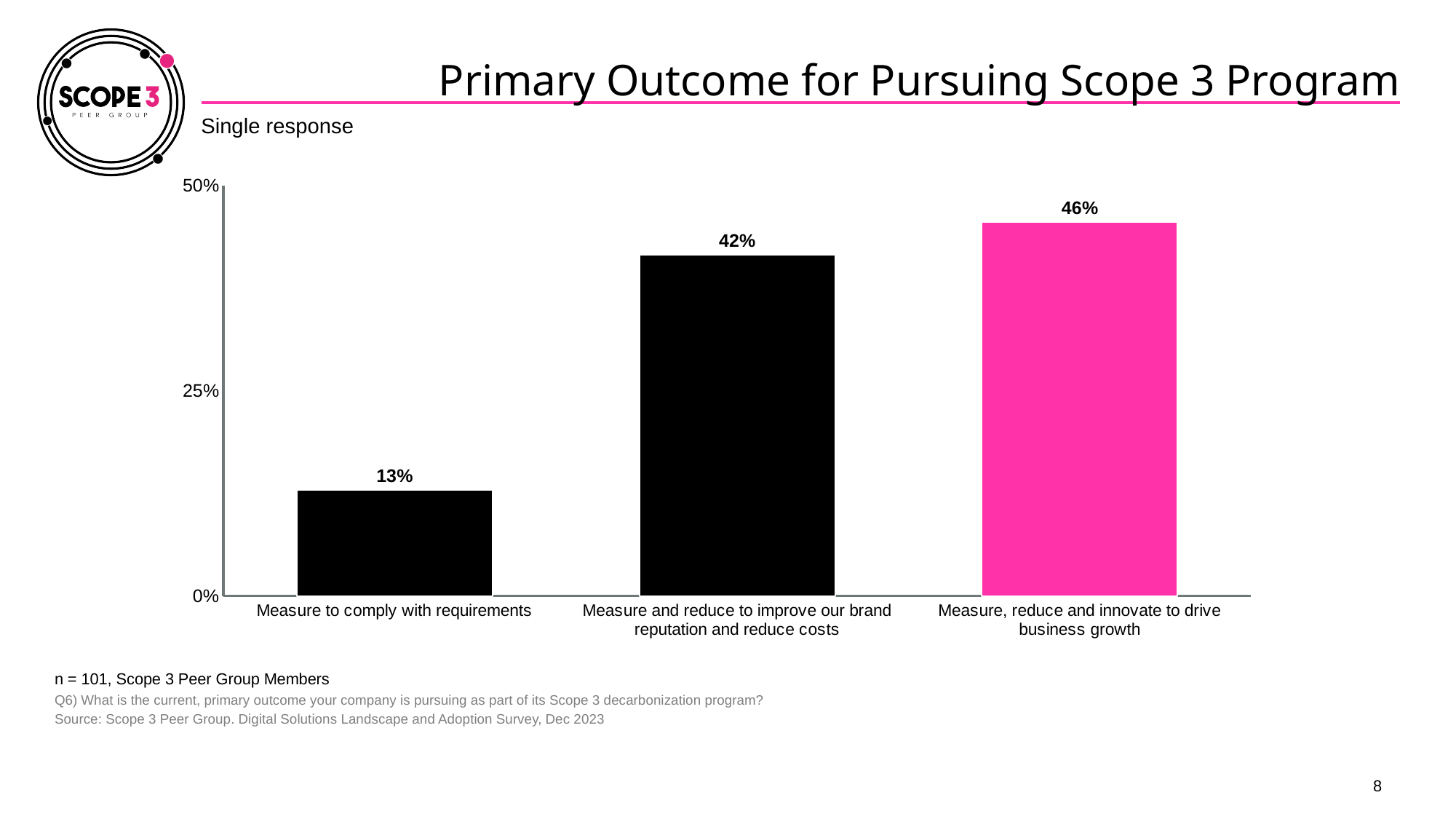
What kind of chart is shown on the slide? Bar chart What is the difference between the values for "Measure, reduce and innovate to drive business growth" and "Measure and reduce to improve our brand reputation and reduce costs"? 4 percentage points What is the value for "Measure and reduce to improve our brand reputation and reduce costs"? 42% What is the value for "Measure, reduce and innovate to drive business growth"? 46% How many categories are shown in the chart? 3 Which has a larger value: "Measure to comply with requirements" or "Measure and reduce to improve our brand reputation and reduce costs"? Measure and reduce to improve our brand reputation and reduce costs Which bar in the chart is coloured pink rather than black? Measure, reduce and innovate to drive business growth Which primary outcome has the lowest percentage of respondents? Measure to comply with requirements Which primary outcome has the highest percentage of respondents? Measure, reduce and innovate to drive business growth What is the difference in percentage points between "Measure, reduce and innovate to drive business growth" and "Measure to comply with requirements"? 33 percentage points Is the value for "Measure to comply with requirements" greater or less than 25%? less What percentage of respondents selected "Measure to comply with requirements" as their primary outcome? 13%